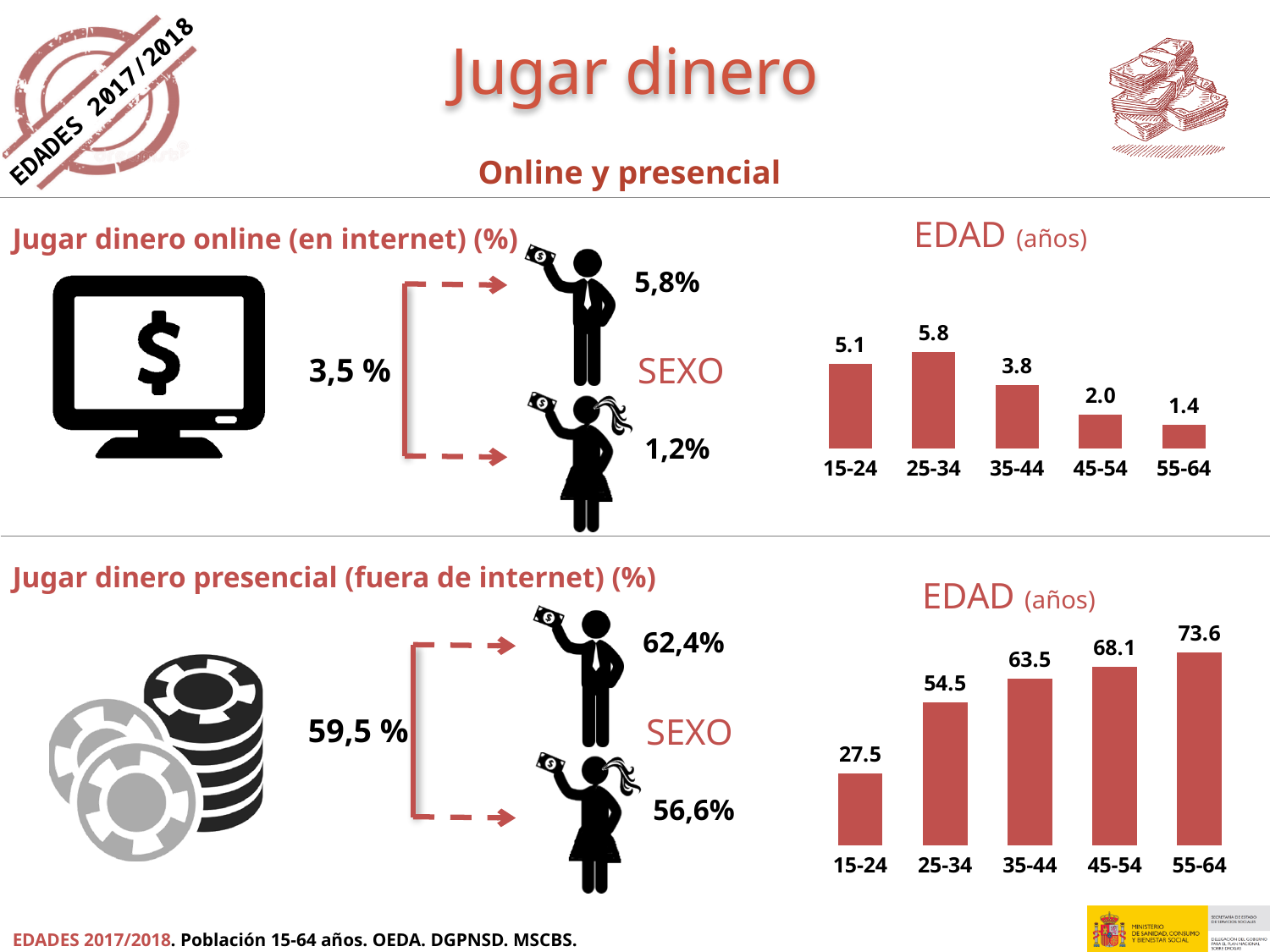
In the top chart (Jugar dinero online, EDAD), what is the difference between the values for 15-24 and 45-54? 3.1 In the top chart (Jugar dinero online, EDAD), how many age groups are shown? 5 In the top chart (Jugar dinero online, EDAD), which age group has the highest value? 25-34 In the bottom chart (Jugar dinero presencial, EDAD), what is the value for the 15-24 age group? 27.5 In the top chart (Jugar dinero online, EDAD), what is the value for the 35-44 age group? 3.8 In the bottom chart (Jugar dinero presencial, EDAD), what is the difference between the values for 55-64 and 15-24? 46.1 In the top chart (Jugar dinero online, EDAD), which age group has the lowest value? 55-64 In the top chart (Jugar dinero online, EDAD), what is the value for the 25-34 age group? 5.8 What type of chart is used to show the EDAD data on the slide? bar chart In the bottom chart (Jugar dinero presencial, EDAD), do the values rise or fall as age increases? rise In the bottom chart (Jugar dinero presencial, EDAD), which age group has the highest value? 55-64 In the bottom chart (Jugar dinero presencial, EDAD), which is larger, the value for 35-44 or for 45-54? 45-54